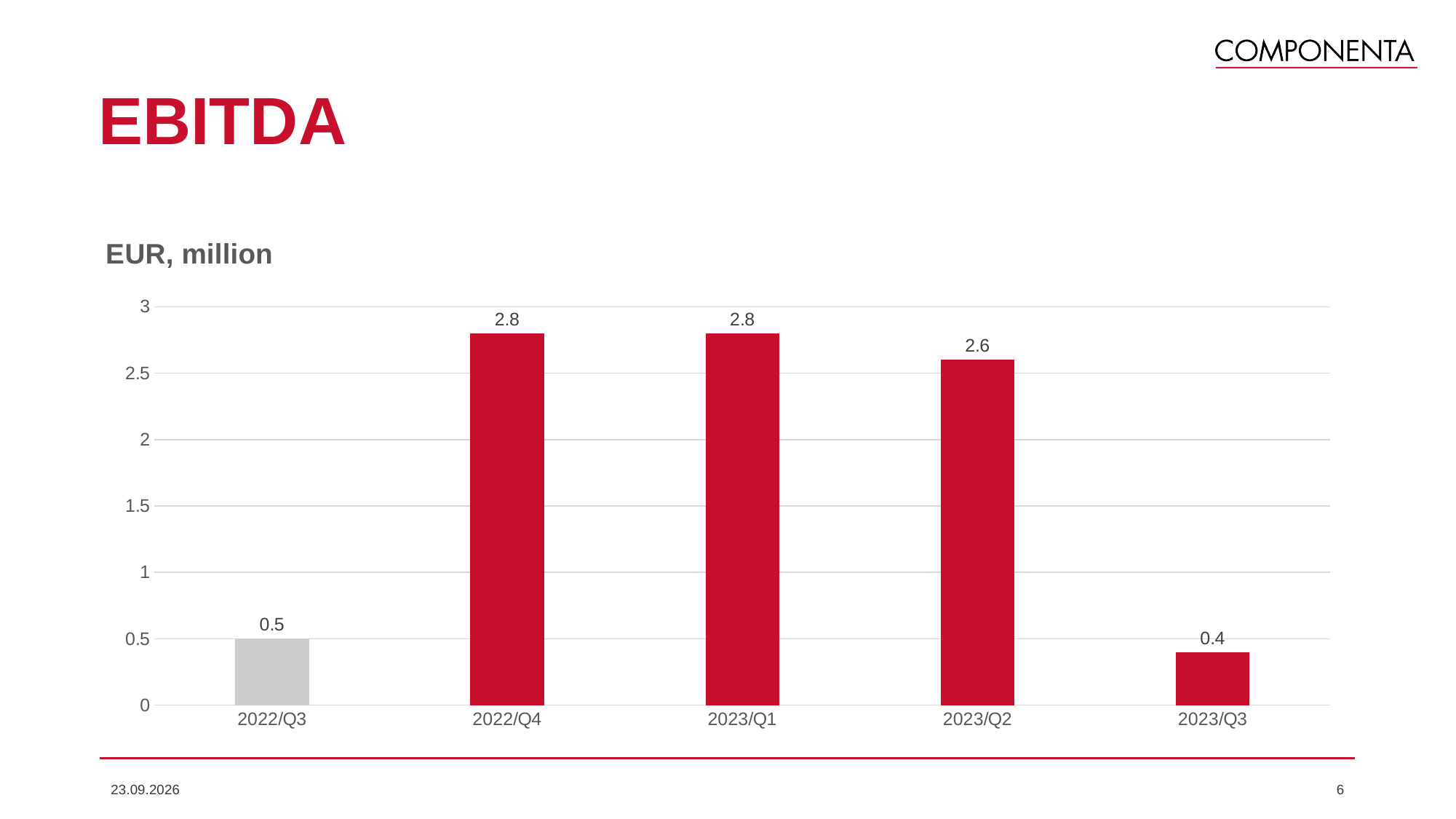
Is the EBITDA value for 2023/Q2 greater or less than 2? greater What is the EBITDA value for 2023/Q2? 2.6 What is the EBITDA value for 2023/Q3? 0.4 Which is larger, the EBITDA for 2022/Q3 or for 2023/Q2? 2023/Q2 What unit is the EBITDA chart measured in? EUR, million Which bar is coloured grey rather than red? 2022/Q3 What is the difference in EBITDA between 2022/Q4 and 2023/Q2? 0.2 What is the difference in EBITDA between 2023/Q1 and 2023/Q3? 2.4 Which quarter has the lowest EBITDA? 2023/Q3 How many quarters are shown in the chart? 5 What is the EBITDA value for 2022/Q3? 0.5 What kind of chart is shown on the slide? bar chart